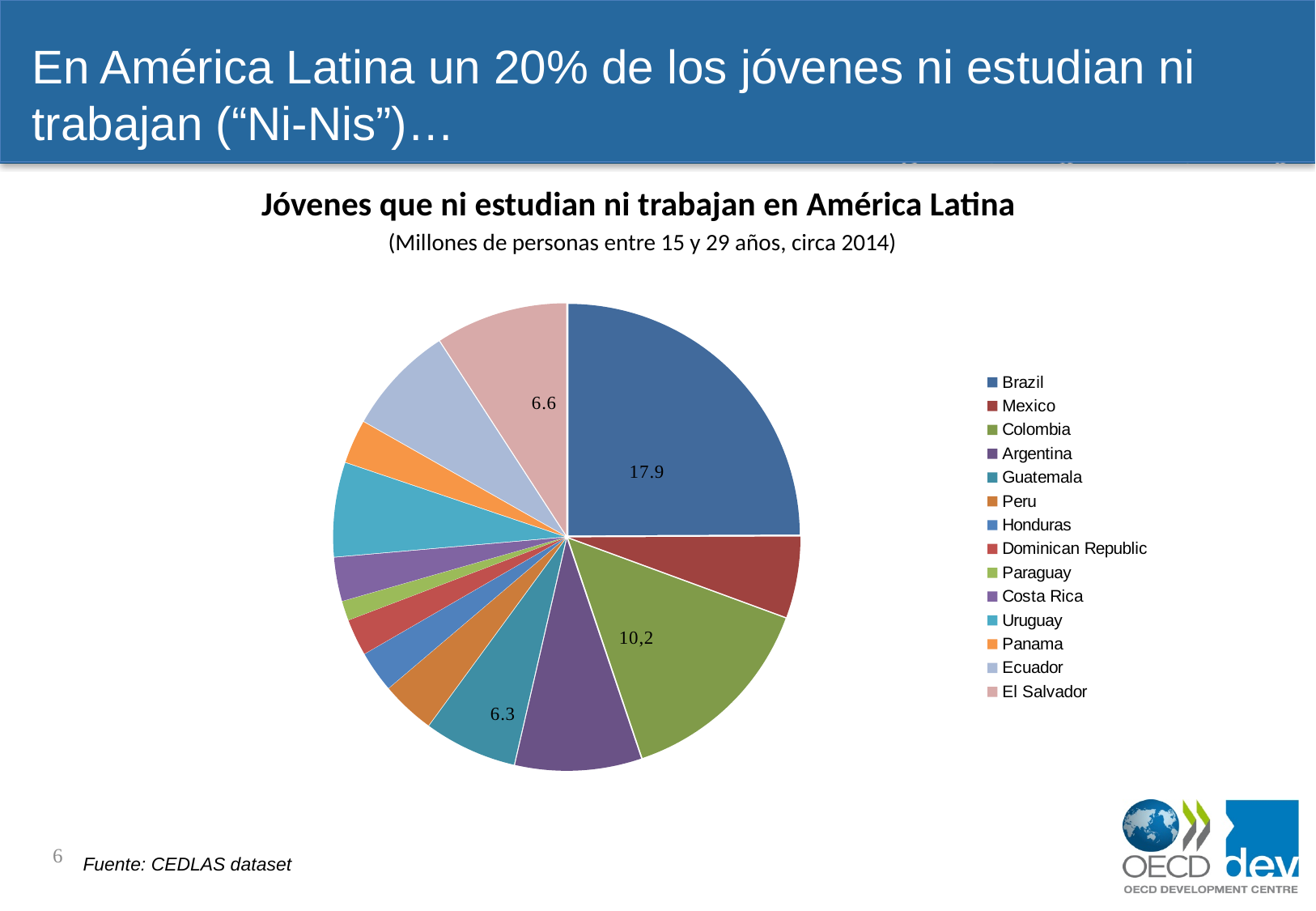
Which country is listed first in the chart legend? Brazil What value is shown for Guatemala in the pie chart? 6.3 Which is larger, the value for Brazil or the value for Colombia? Brazil What value is shown for El Salvador in the pie chart? 6.6 How many countries does the legend of the pie chart list? 14 What value is shown for Brazil in the pie chart? 17.9 What is the title of the chart? Jóvenes que ni estudian ni trabajan en América Latina What value is shown for Colombia in the pie chart? 10,2 What kind of chart is shown on the slide? pie chart Which slice is larger, Brazil or Mexico? Brazil Which is larger, the value for Guatemala or the value for El Salvador? El Salvador Which country has the largest slice of the pie chart? Brazil